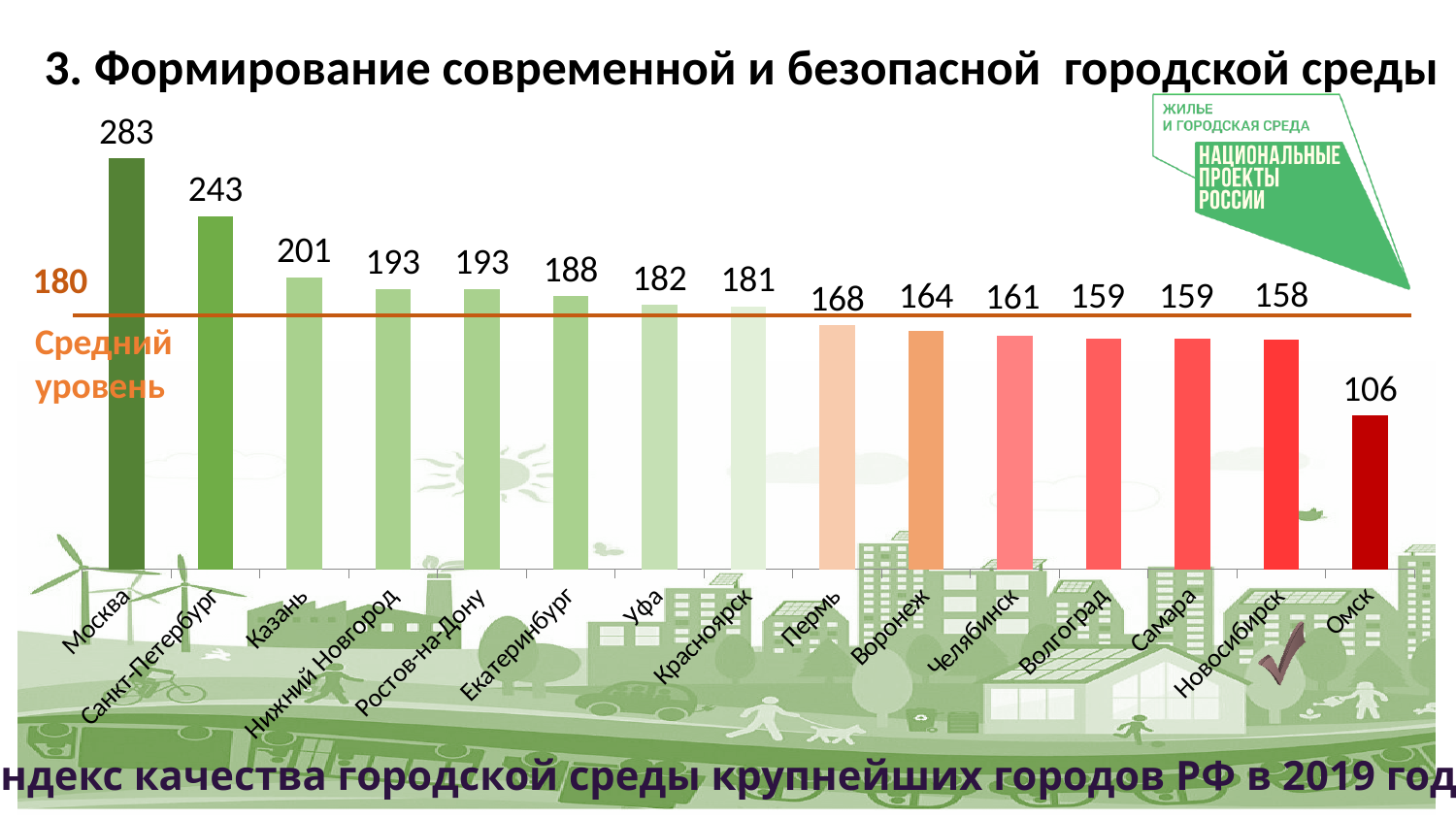
Which is larger, the value for Пермь or the value for Воронеж? Пермь Which city has the highest value? Москва What is the value for Москва? 283 How many cities are shown in the chart? 15 What value does the horizontal line labelled 'Средний уровень' mark? 180 Which city has the lowest value? Омск What is the value for Екатеринбург? 188 What is the difference between the values for Казань and Омск? 95 What kind of chart is shown on the slide? bar chart What is the difference between the values for Москва and Санкт-Петербург? 40 Is the value for Уфа greater or less than the average level of 180 marked on the chart? greater What is the value for Новосибирск? 158